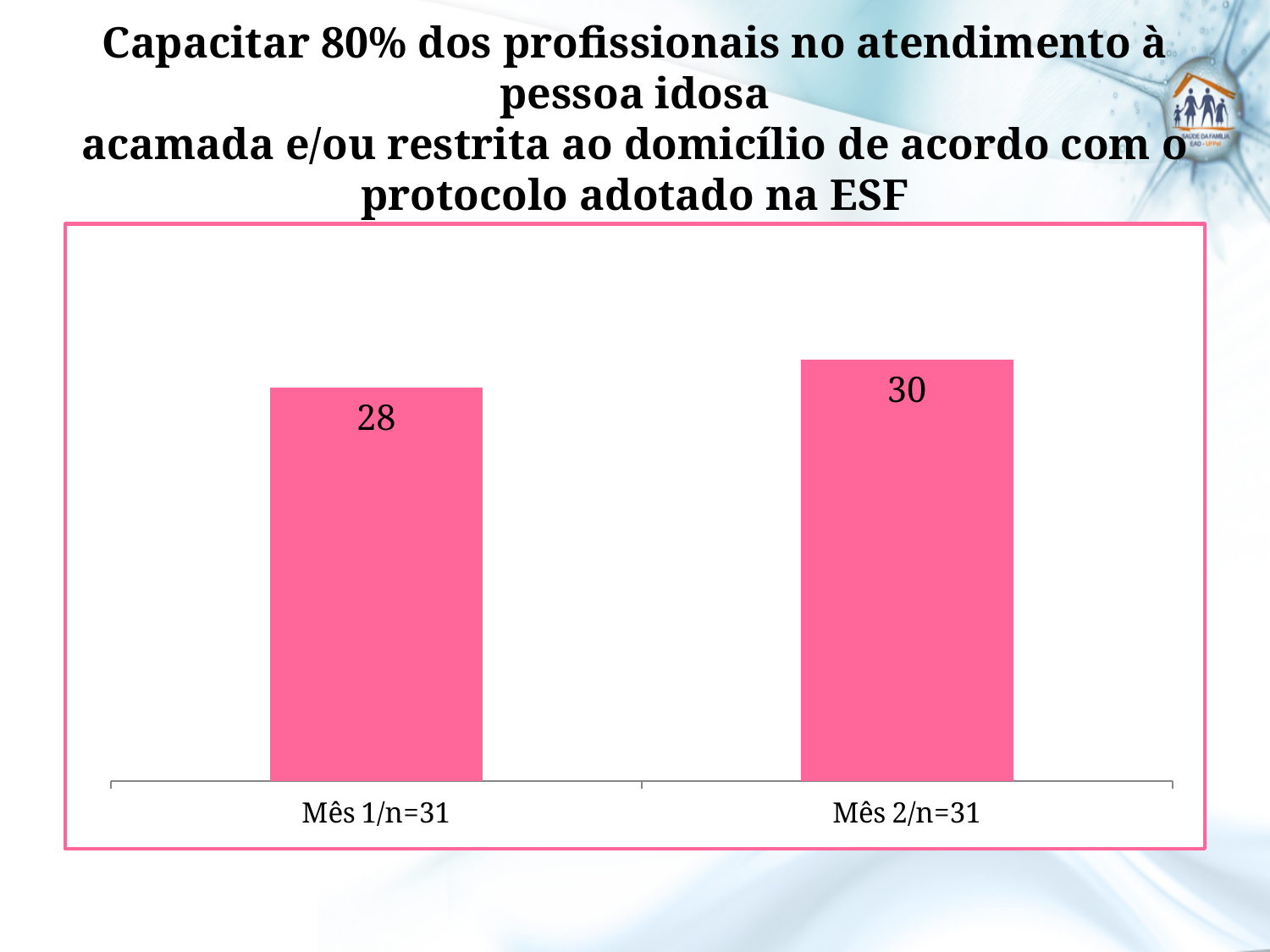
Do the values rise or fall from Mês 1/n=31 to Mês 2/n=31? rise What is the difference between the values for Mês 2/n=31 and Mês 1/n=31? 2 What kind of chart is shown on the slide? bar chart Which category has the lowest value? Mês 1/n=31 What is the value for Mês 1/n=31? 28 Which category has the highest value? Mês 2/n=31 How many categories are shown on the x axis? 2 Which is larger, the value for Mês 1/n=31 or the value for Mês 2/n=31? Mês 2/n=31 What colour are the bars in the chart? pink What is the value for Mês 2/n=31? 30 What is the label of the first category on the x axis? Mês 1/n=31